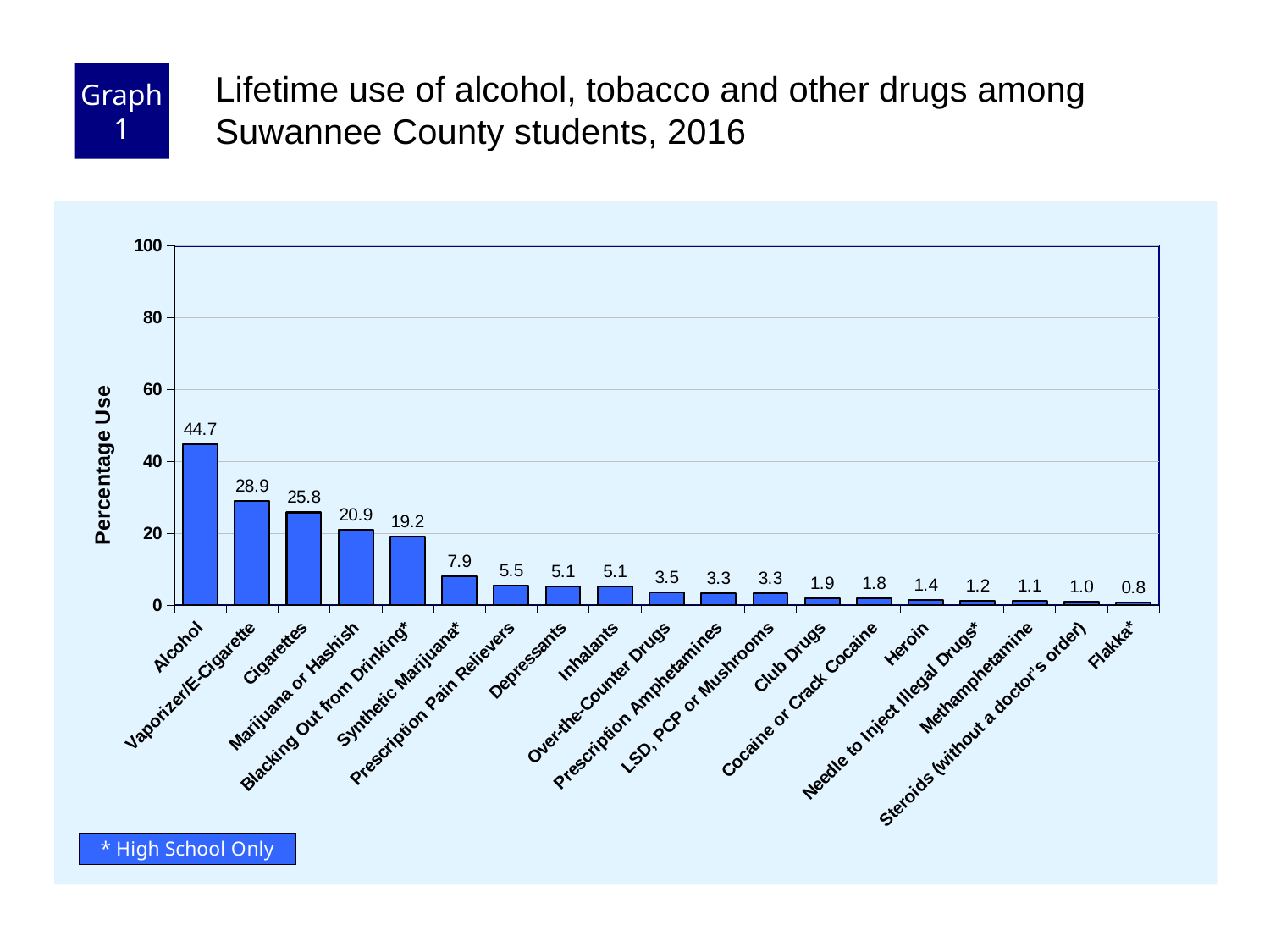
What is the percentage of lifetime use for Vaporizer/E-Cigarette? 28.9 Which category has the lowest percentage of lifetime use? Flakka* What is the percentage of lifetime use for Alcohol? 44.7 What kind of chart is shown on the slide? Bar chart What is the difference in percentage use between Cigarettes and Marijuana or Hashish? 4.9 Which category has the highest percentage of lifetime use? Alcohol Is the value for Alcohol greater or less than 40? greater Which has a higher percentage of lifetime use, Blacking Out from Drinking or Synthetic Marijuana? Blacking Out from Drinking* How many categories are shown on the x axis? 19 What is the percentage of lifetime use for Synthetic Marijuana? 7.9 What is the label of the y axis? Percentage Use What is the percentage of lifetime use for Heroin? 1.4